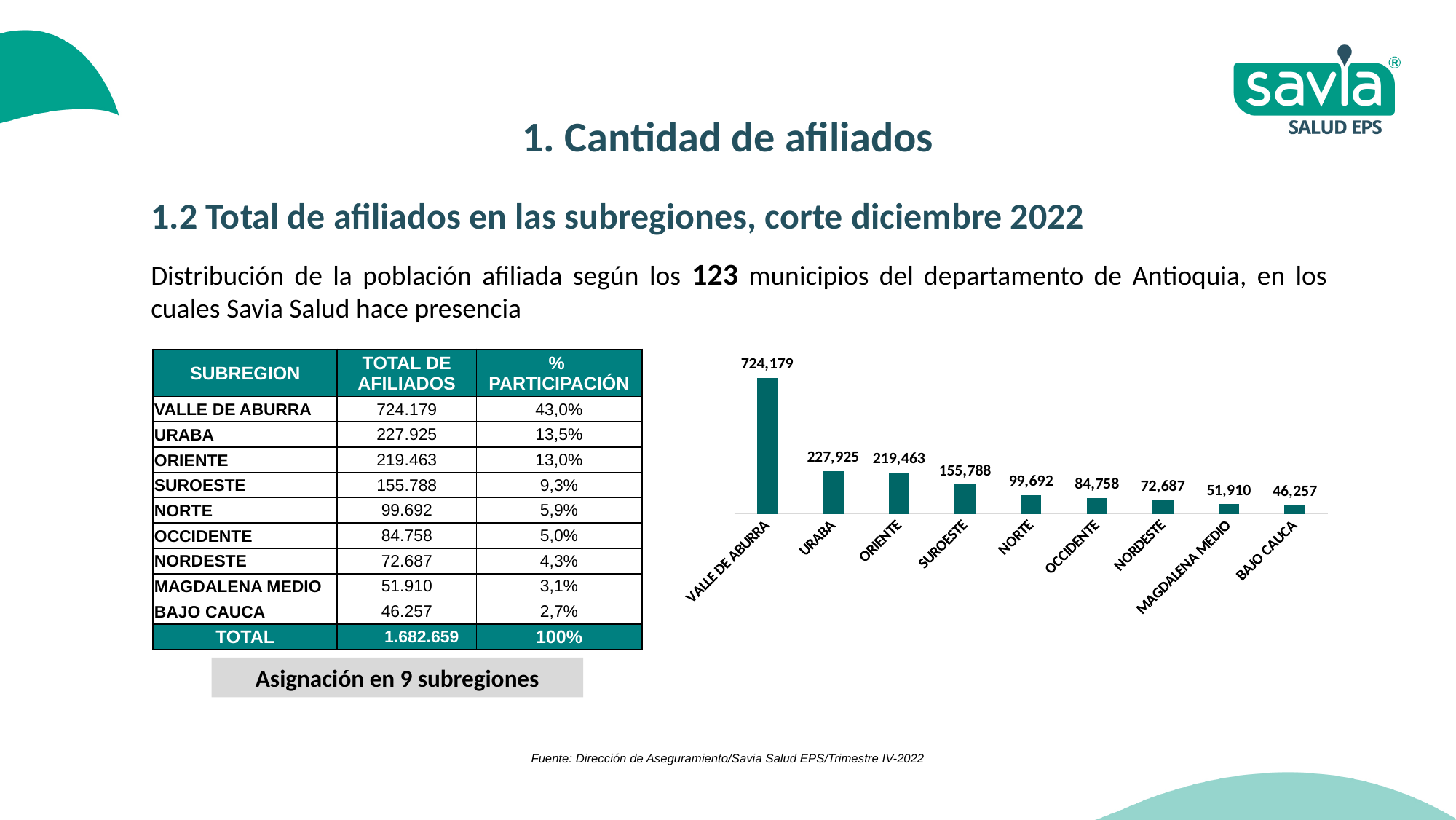
Which subregion has the highest value in the bar chart? VALLE DE ABURRA What is the value shown for SUROESTE in the bar chart? 155,788 What colour are the bars in the chart? teal What is the value shown for VALLE DE ABURRA in the bar chart? 724,179 How many subregions are plotted in the bar chart? 9 Which subregion has the lowest value in the bar chart? BAJO CAUCA Which has a larger value in the bar chart, NORDESTE or BAJO CAUCA? NORDESTE What is the difference between the values for NORTE and OCCIDENTE in the bar chart? 14,934 What is the value shown for MAGDALENA MEDIO in the bar chart? 51,910 Do the values in the bar chart rise or fall from left to right along the x axis? fall What is the difference between the values for URABA and ORIENTE in the bar chart? 8,462 What kind of chart is shown on the slide? bar chart